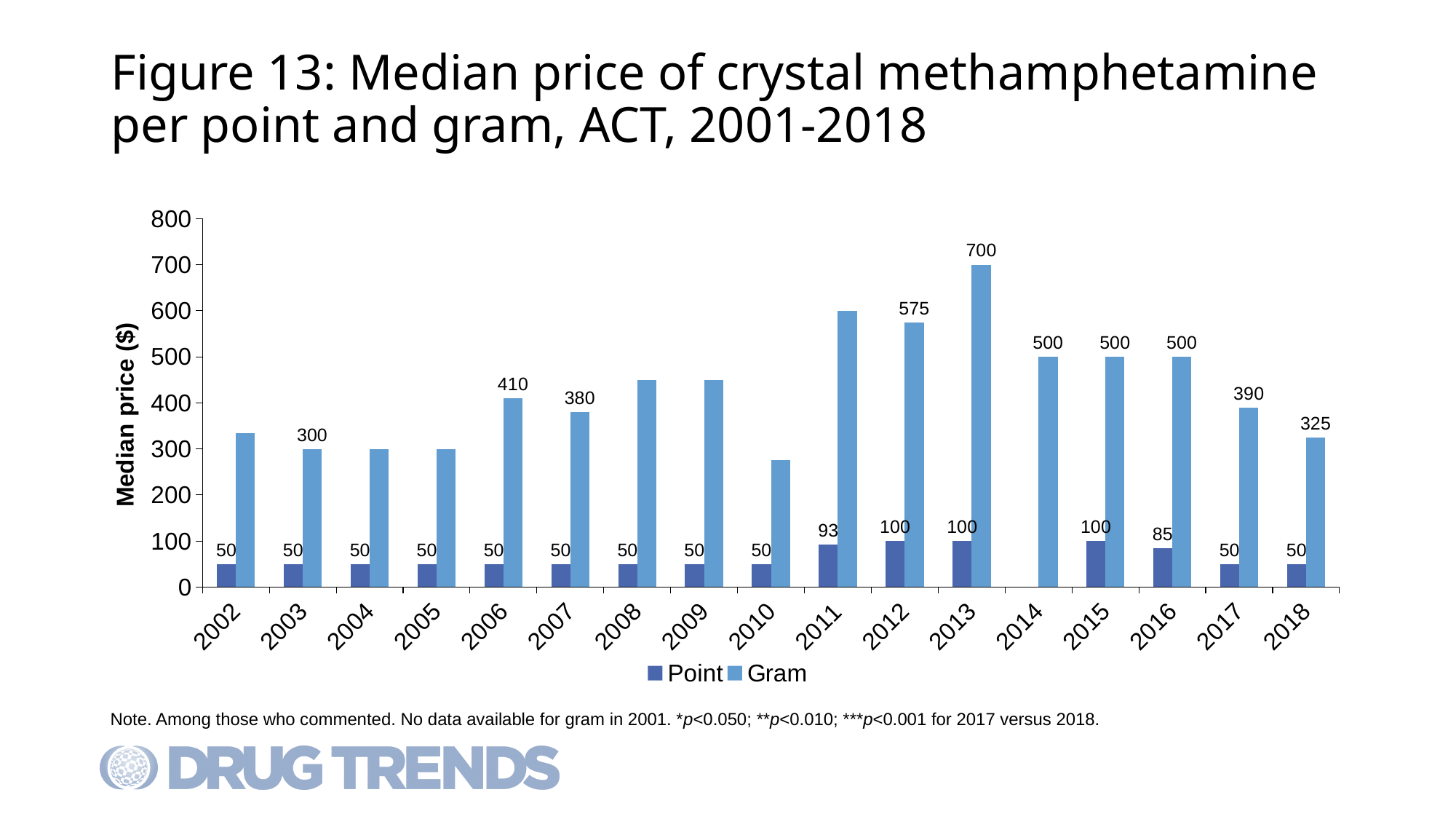
What is the median price per gram in 2013? 700 What kind of chart is shown on the slide? bar chart How many years are shown on the x axis? 17 Is the median price per gram in 2010 greater or less than 300? less How many series does the legend list? 2 What is the difference between the median price per point in 2012 and in 2016? 15 Is the median price per gram in 2011 greater or less than 500? greater Which year has the higher median price per gram, 2006 or 2007? 2006 What is the difference between the median price per gram in 2017 and in 2018? 65 What is the median price per point in 2011? 93 What is the median price per point in 2016? 85 In which year is the median price per gram highest? 2013